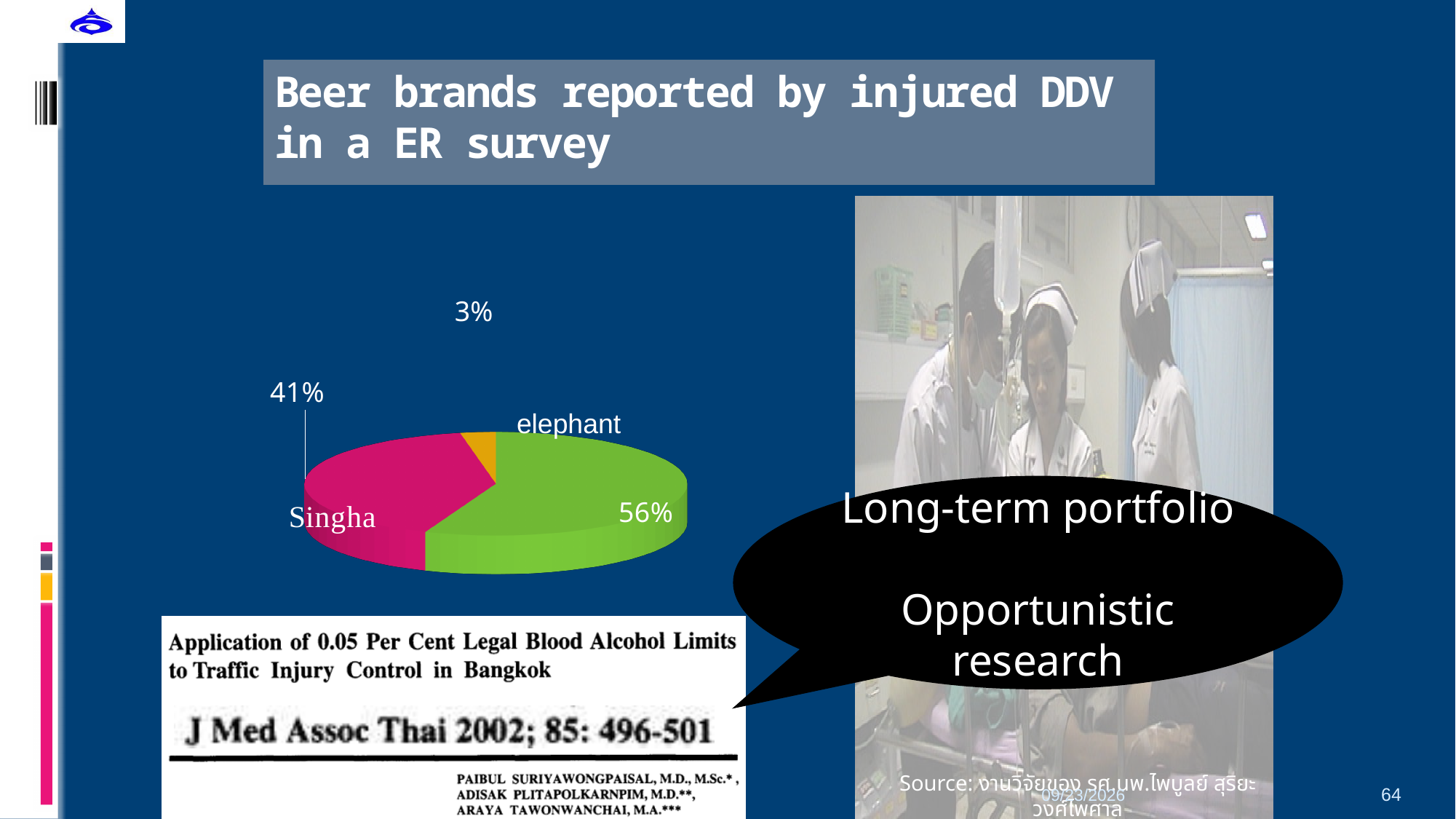
Is the share for Singha greater or less than 50%? less What colour is the Singha slice of the pie chart? Pink What is the difference in percentage points between the elephant slice and the Singha slice? 15% What percentage of the pie is labelled for Singha? 41% What percentage of the pie is labelled for elephant? 56% Which beer brand has the largest slice of the pie? elephant What is the title of the slide containing the pie chart? Beer brands reported by injured DDV in a ER survey What type of chart is shown on the slide? Pie chart Which slice is larger, elephant or Singha? elephant How many slices does the pie chart have? 3 What percentage is shown on the smallest slice of the pie? 3%